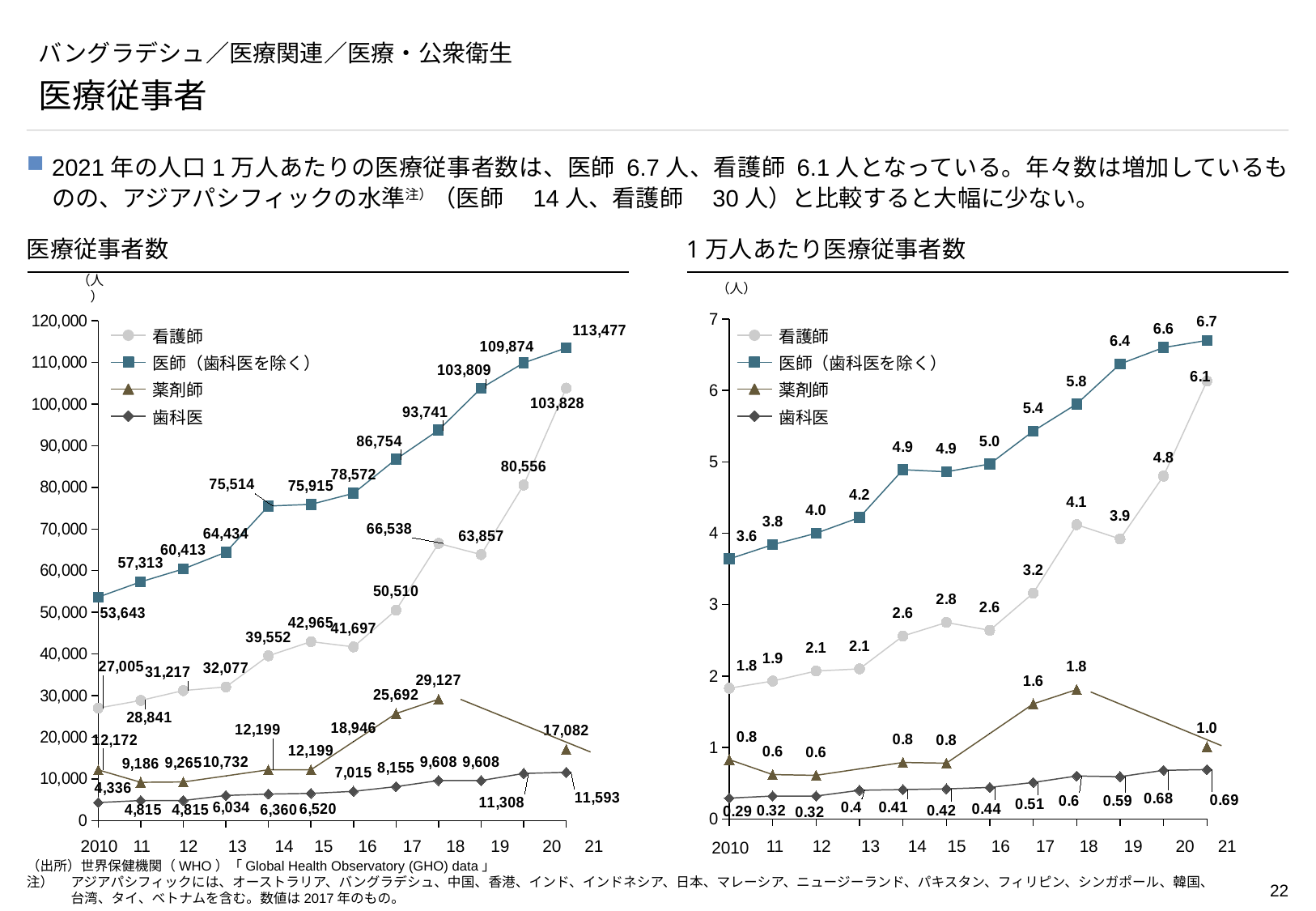
In the left chart (医療従事者数), what is the value for 歯科医 in 2021? 11,593 In the right chart (1万人あたり医療従事者数), which is larger in 2018: 看護師 or 薬剤師? 看護師 In the right chart (1万人あたり医療従事者数), does the value for 医師（歯科医を除く） rise or fall from 2010 to 2021? Rise What kind of chart is the right chart (1万人あたり医療従事者数)? Line chart In the right chart (1万人あたり医療従事者数), what is the value for 医師（歯科医を除く） in 2021? 6.7 In the left chart (医療従事者数), what is the value for 看護師 in 2010? 27,005 In the left chart (医療従事者数), how many series does the legend list? 4 In the right chart (1万人あたり医療従事者数), what is the value for 歯科医 in 2010? 0.29 In the left chart (医療従事者数), what is the difference between 医師（歯科医を除く） and 看護師 in 2021? 9,649 In the right chart (1万人あたり医療従事者数), what is the difference between 医師（歯科医を除く） and 看護師 in 2021? 0.6 In the left chart (医療従事者数), which series has the highest value in 2021? 医師（歯科医を除く） In the left chart (医療従事者数), what is the value for 医師（歯科医を除く） in 2021? 113,477